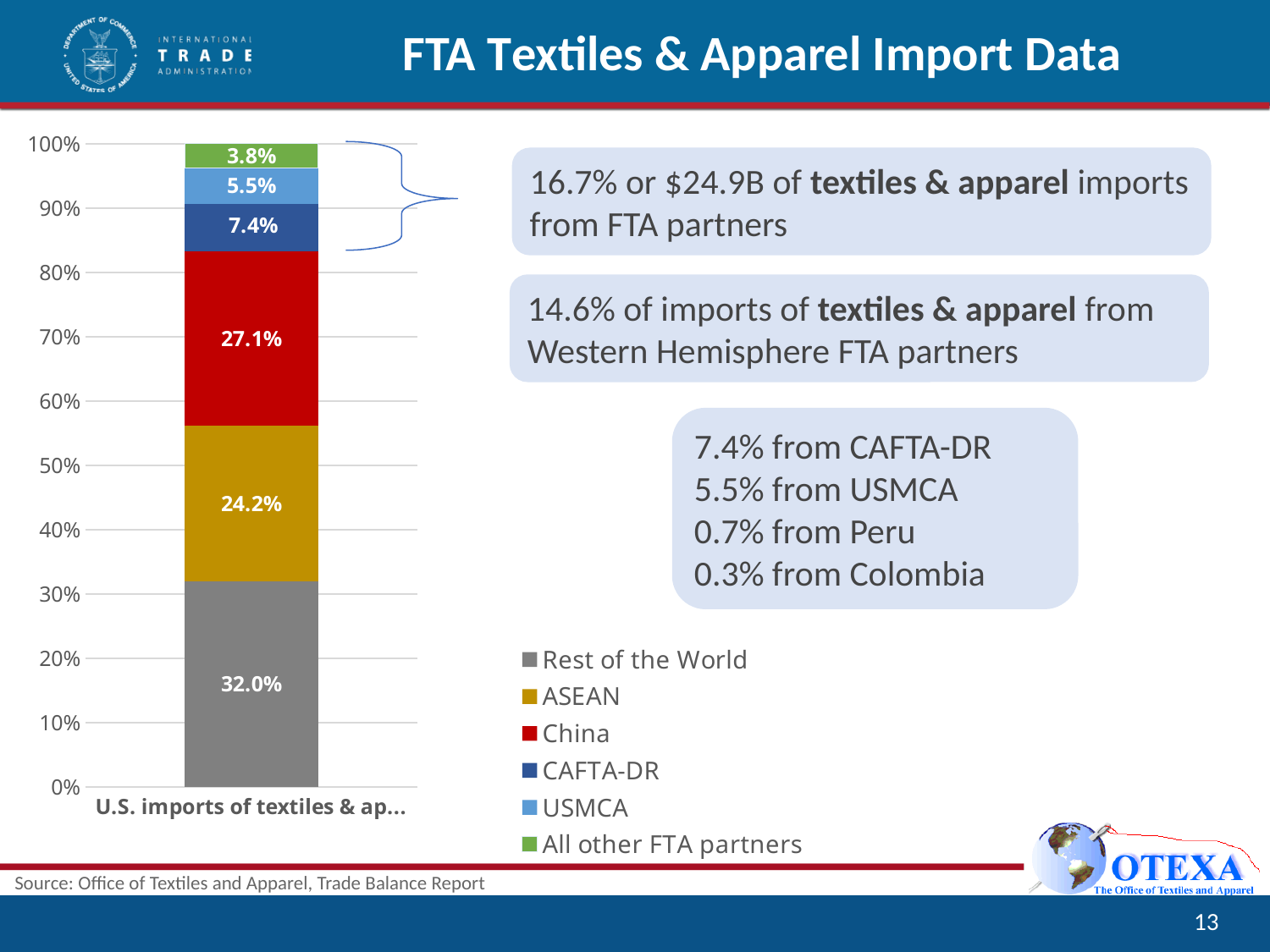
By how many percentage points does China's share exceed ASEAN's share? 2.9 percentage points What is the value shown for ASEAN in the stacked bar? 24.2% Which series has the smallest segment in the stacked bar? All other FTA partners Which series has the largest segment in the stacked bar? Rest of the World What colour represents China in the chart? Red How many series does the legend list? 6 What is the value shown for USMCA in the stacked bar? 5.5% What kind of chart is shown on the slide? Stacked bar chart What is the value shown for CAFTA-DR in the stacked bar? 7.4% What share of U.S. textiles and apparel imports comes from the Rest of the World according to the chart? 32.0% Which is larger, the share for CAFTA-DR or the share for USMCA? CAFTA-DR What is the value shown for China in the stacked bar? 27.1%